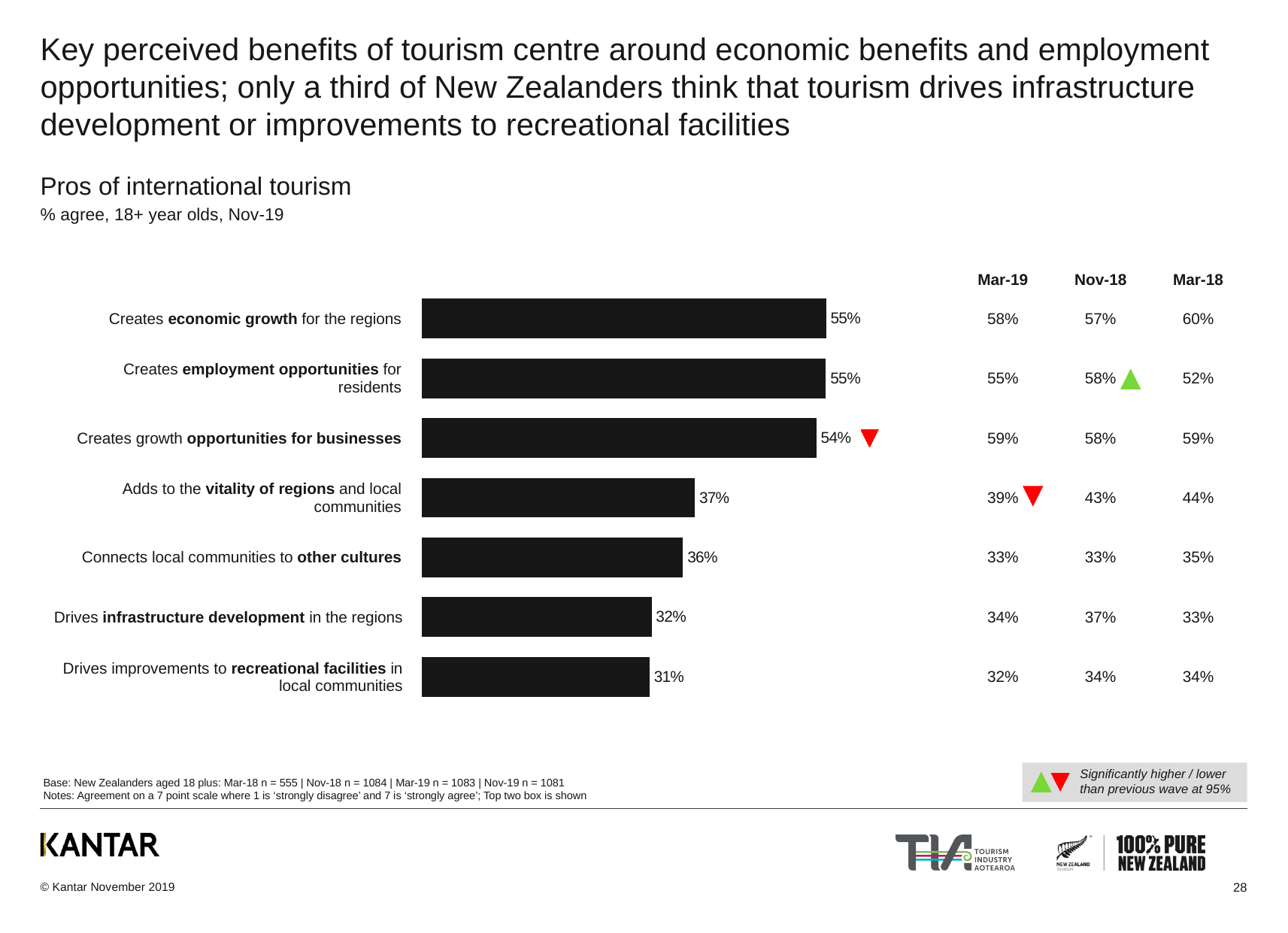
What is the Nov-19 value for 'Creates growth opportunities for businesses'? 54% Which has the larger Nov-19 value: 'Adds to the vitality of regions and local communities' or 'Connects local communities to other cultures'? Adds to the vitality of regions and local communities What percentage agree that tourism drives infrastructure development in the regions (Nov-19)? 32% What percentage agree that tourism creates economic growth for the regions (Nov-19)? 55% What kind of chart is shown on the slide? bar chart Which category has the lowest Nov-19 value in the bar chart? Drives improvements to recreational facilities in local communities How many categories (pros of international tourism) are plotted in the bar chart? 7 What was the Mar-19 value for 'Creates growth opportunities for businesses'? 59% What was the Mar-18 value for 'Creates economic growth for the regions'? 60% What is the difference between the Nov-19 values for 'Creates economic growth for the regions' and 'Drives infrastructure development in the regions'? 23 percentage points What is the title of the chart? Pros of international tourism What is the difference between the Nov-18 and Nov-19 values for 'Adds to the vitality of regions and local communities'? 6 percentage points